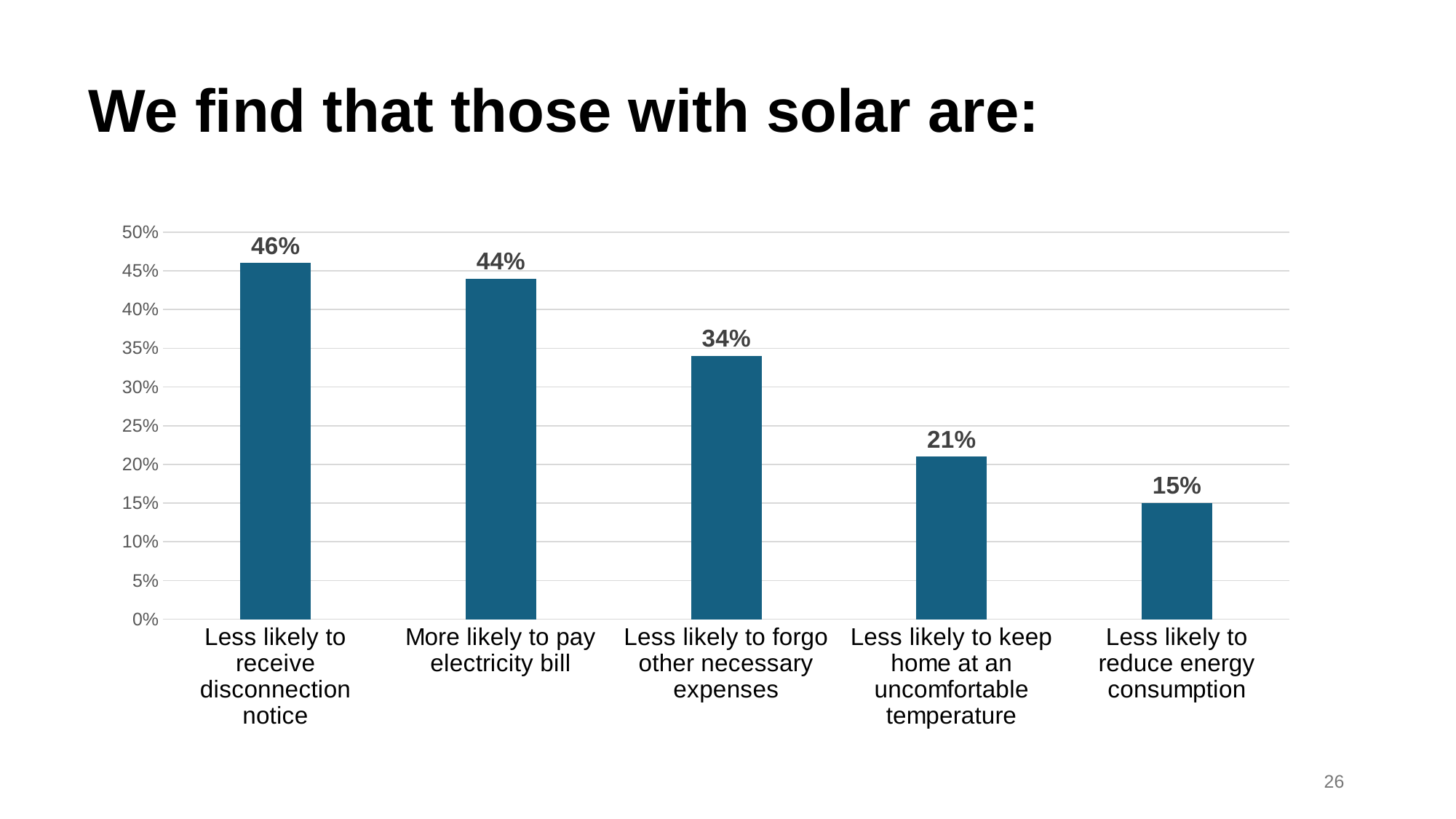
Which category has the highest value? Less likely to receive disconnection notice What is the value for "Less likely to forgo other necessary expenses"? 34% Which category has the lowest value? Less likely to reduce energy consumption How many categories are shown in the chart? 5 What is the difference between the values for "Less likely to forgo other necessary expenses" and "Less likely to keep home at an uncomfortable temperature"? 13% What is the value for "Less likely to receive disconnection notice"? 46% What is the value for "More likely to pay electricity bill"? 44% What is the value for "Less likely to keep home at an uncomfortable temperature"? 21% Do the values rise or fall from left to right across the categories? Fall Which is larger: the value for "Less likely to keep home at an uncomfortable temperature" or "Less likely to reduce energy consumption"? Less likely to keep home at an uncomfortable temperature What kind of chart is shown on the slide? Bar chart What is the value for "Less likely to reduce energy consumption"? 15%